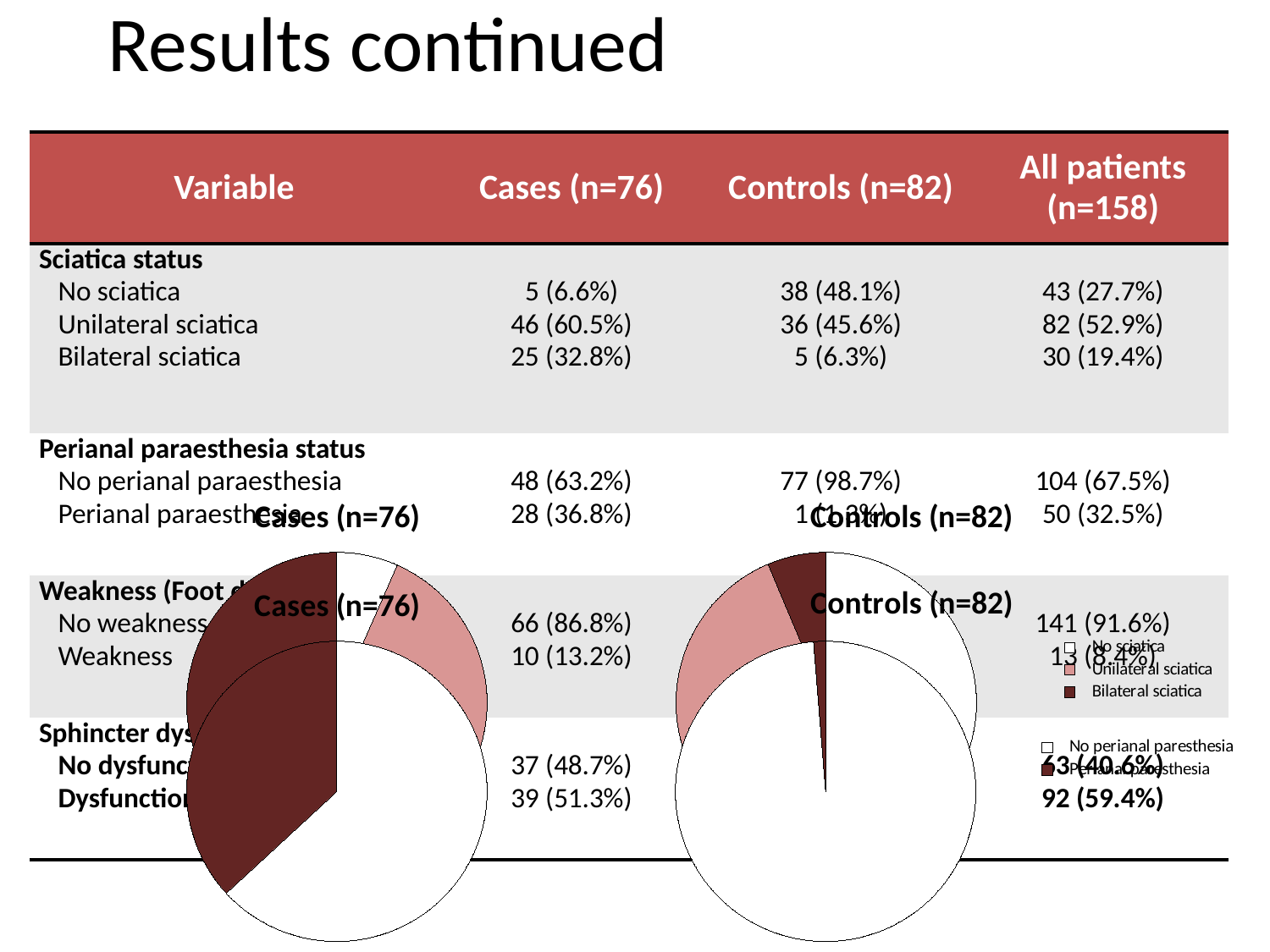
How many categories does the sciatica legend list? 3 How many pie charts are shown on the slide? 4 Comparing the front Cases (n=76) and front Controls (n=82) pie charts, which has the larger Perianal paraesthesia slice? Cases (n=76) In the front Cases (n=76) pie chart, which slice is larger: No perianal paresthesia or Perianal paraesthesia? No perianal paresthesia How many categories does the perianal paresthesia legend list? 2 What colour represents No sciatica in the sciatica legend? White In the front Controls (n=82) pie chart, which category has the largest slice? No perianal paresthesia In the back Controls (n=82) sciatica pie chart, which category has the smallest slice? Bilateral sciatica What kind of chart is used for the Cases (n=76) and Controls (n=82) charts on the slide? Pie chart In the front Controls (n=82) pie chart, which category has the smallest slice? Perianal paresthesia What colour represents Bilateral sciatica in the sciatica legend? Dark red